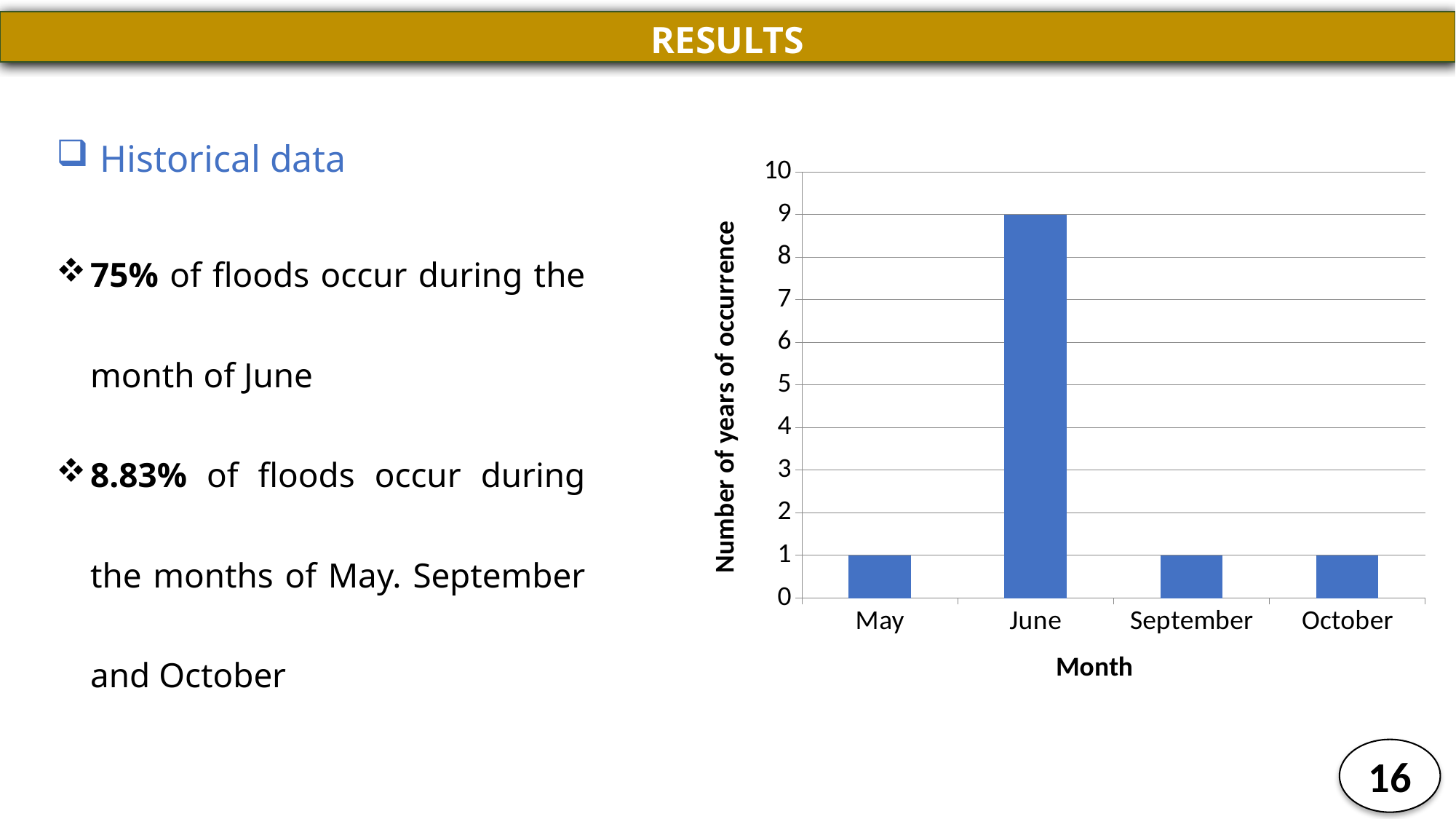
What is the number of years of occurrence for June? 9 What is the number of years of occurrence for October? 1 Which month has the highest number of years of occurrence? June What is the difference between the number of years of occurrence for June and for September? 8 Is the value for June greater or less than 5? greater Is the value for September greater or less than 2? less What is the label of the vertical axis of the chart? Number of years of occurrence What is the number of years of occurrence for May? 1 What is the label of the horizontal axis of the chart? Month Which has a higher number of years of occurrence, June or May? June What type of chart is shown on the slide? bar chart How many months are shown on the x axis of the chart? 4